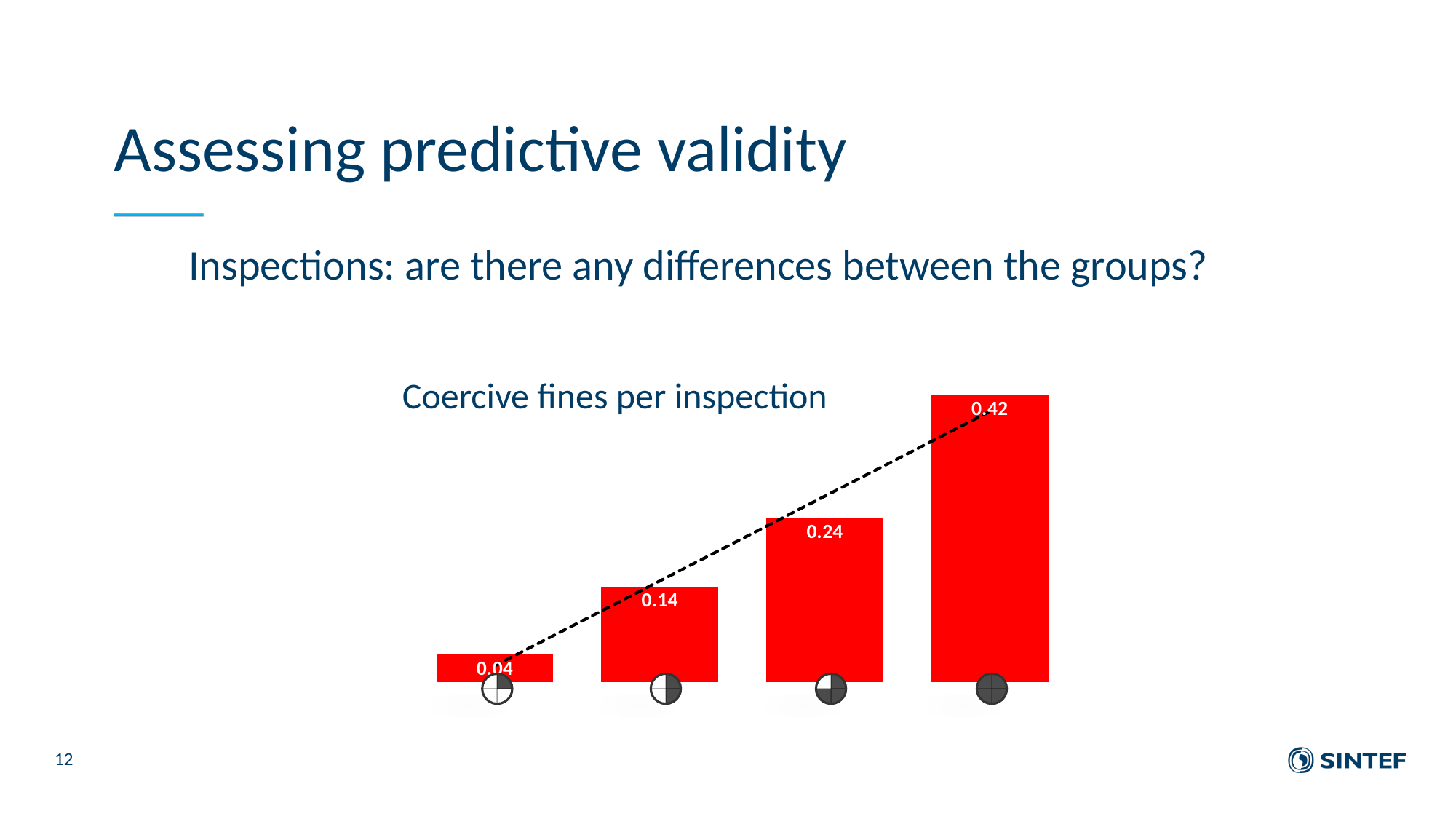
What is the highest value shown in the 'Coercive fines per inspection' chart? 0.42 What is the value of the leftmost bar in the 'Coercive fines per inspection' chart? 0.04 What is the difference between the rightmost bar and the leftmost bar in the 'Coercive fines per inspection' chart? 0.38 What is the difference between the third bar and the second bar in the 'Coercive fines per inspection' chart? 0.10 Do the values in the 'Coercive fines per inspection' chart rise or fall from left to right? rise Which is larger in the 'Coercive fines per inspection' chart: the second bar from the left or the third bar from the left? the third bar from the left What is the value of the third bar from the left in the 'Coercive fines per inspection' chart? 0.24 How many bars are shown in the 'Coercive fines per inspection' chart? 4 What is the lowest value shown in the 'Coercive fines per inspection' chart? 0.04 What is the value of the second bar from the left in the 'Coercive fines per inspection' chart? 0.14 What is the value of the rightmost bar in the 'Coercive fines per inspection' chart? 0.42 What kind of chart is used to show 'Coercive fines per inspection'? bar chart